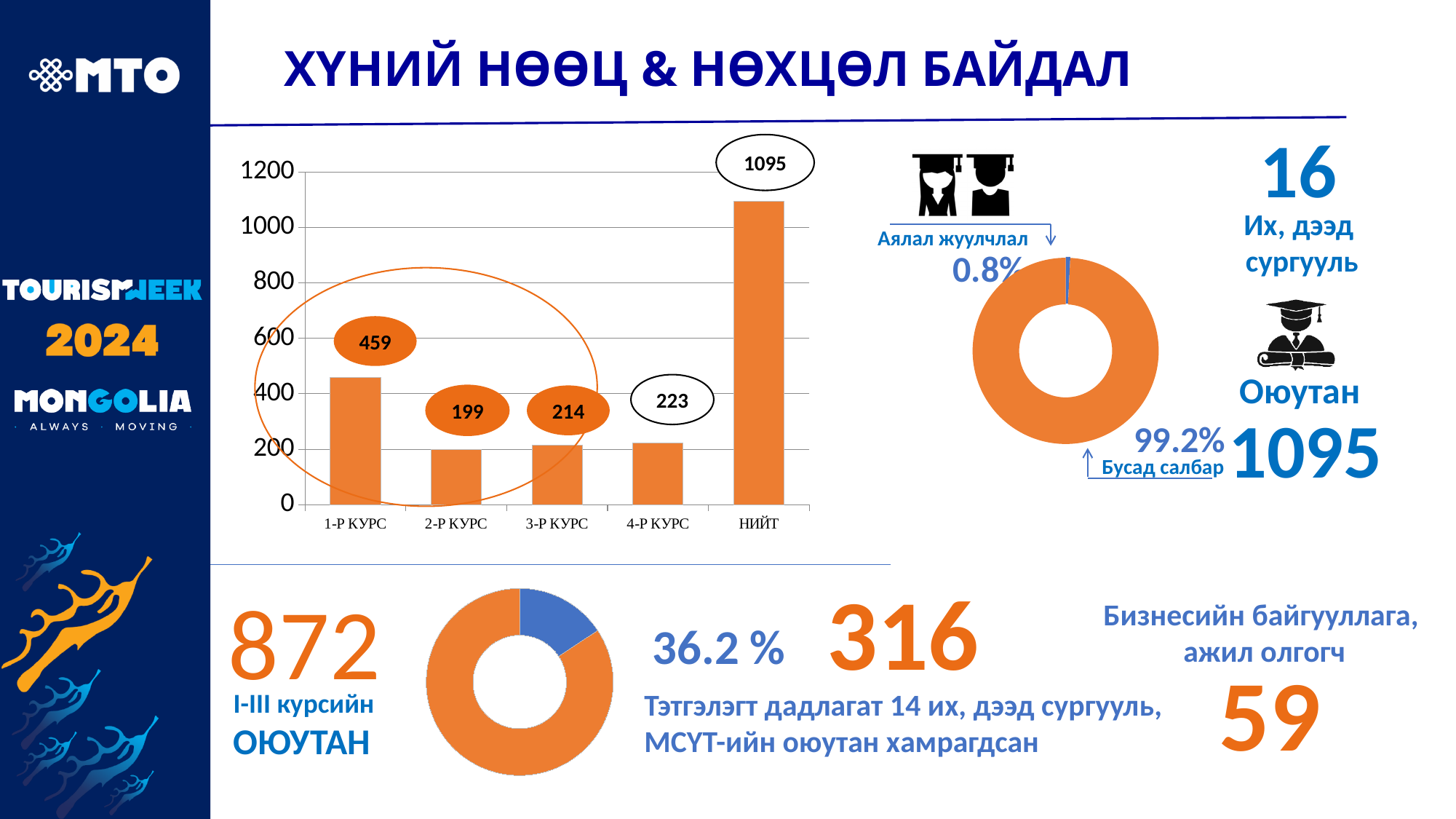
In the bar chart on the left, which is larger: the value for 2-Р КУРС or 3-Р КУРС? 3-Р КУРС How many categories are shown on the x axis of the bar chart on the left? 5 In the bar chart on the left, which category has the highest value? НИЙТ In the donut chart at the bottom of the slide, what percentage is printed next to the blue slice? 36.2 % In the bar chart on the left, what is the difference between the values for 1-Р КУРС and 4-Р КУРС? 236 What kind of chart is the chart on the left with the КУРС categories? bar chart In the bar chart on the left, which category has the lowest value? 2-Р КУРС In the bar chart on the left, what is the value for НИЙТ? 1095 In the bar chart on the left, what is the value for 1-Р КУРС? 459 In the donut chart on the upper right, what share is labelled Бусад салбар? 99.2% In the donut chart on the upper right, what share is labelled Аялал жуулчлал? 0.8% In the bar chart on the left, what is the value for 3-Р КУРС? 214